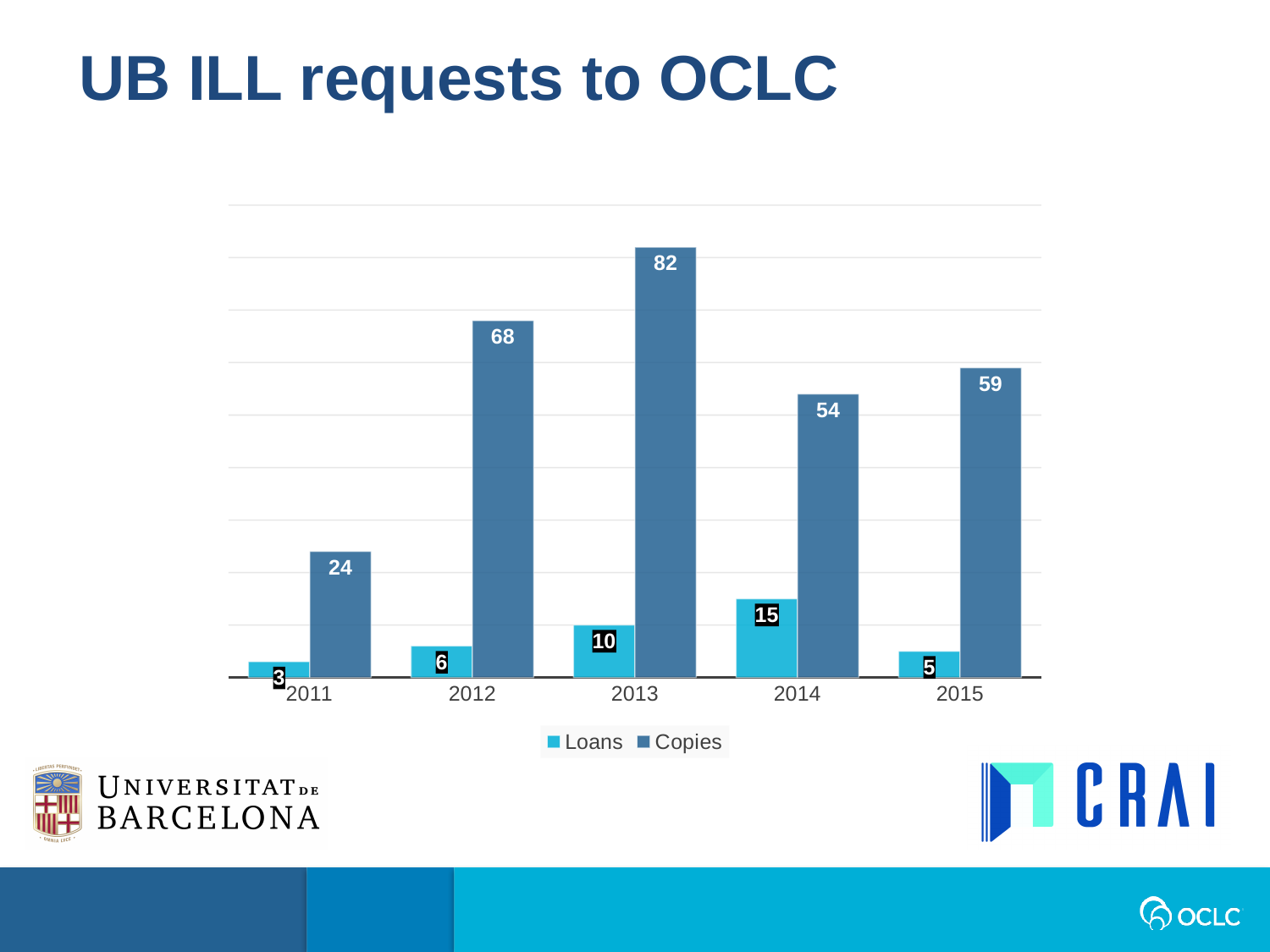
What is the difference between Copies in 2012 and Copies in 2014? 14 What kind of chart is shown on the slide? Bar chart Do the Loans values rise or fall from 2011 to 2014? Rise Which year has the highest value for Copies? 2013 What is the title of the slide? UB ILL requests to OCLC How many series does the legend list? 2 Which year has the lowest value for Loans? 2011 What is the value for Loans in 2014? 15 What is the value for Copies in 2013? 82 How many years are shown on the x axis? 5 Which is larger, Copies in 2015 or Copies in 2014? Copies in 2015 What is the value for Copies in 2011? 24